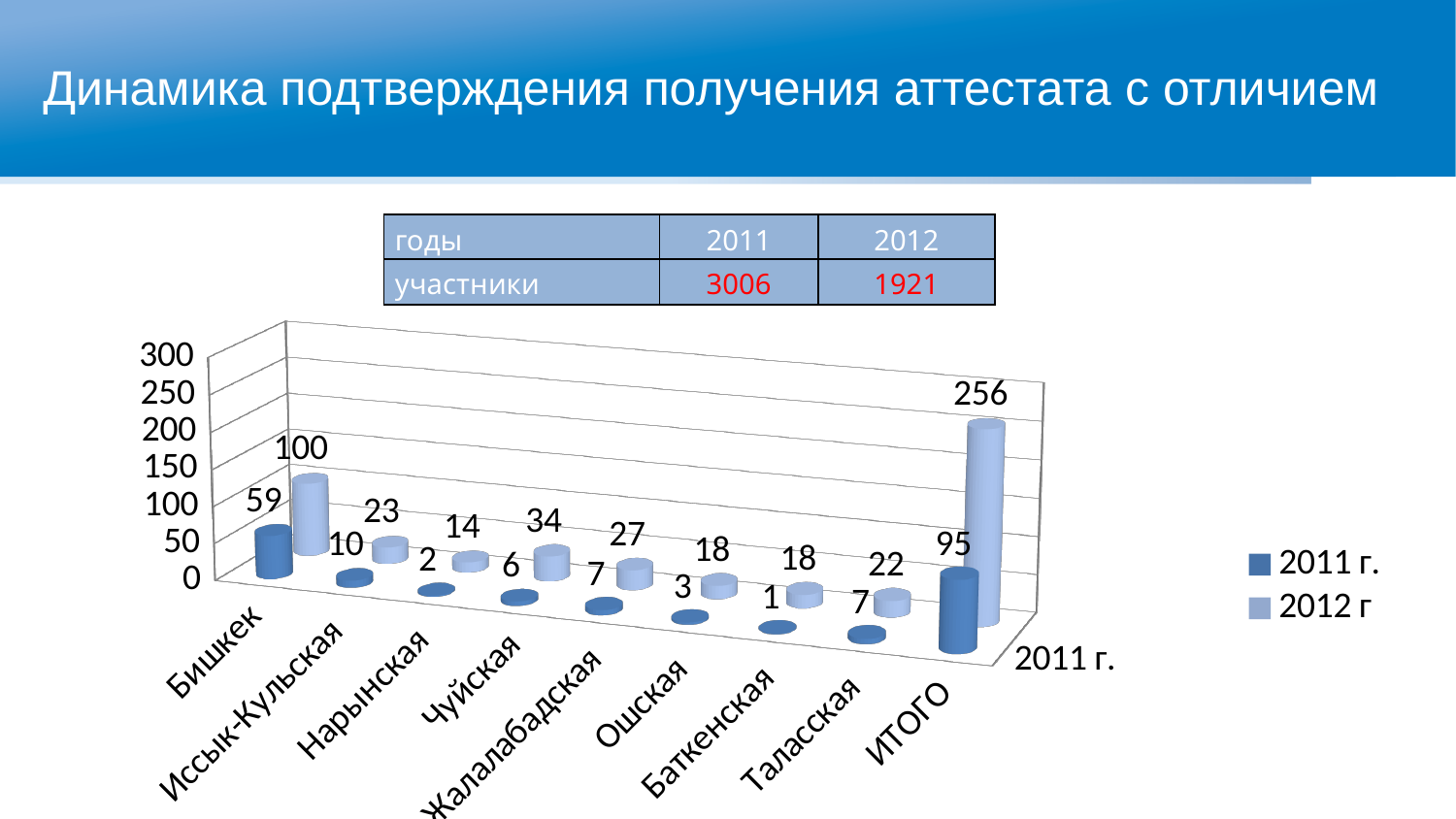
What is the value for Чуйская in the 2012 г series? 34 Which region (excluding ИТОГО) has the highest value in the 2012 г series? Бишкек What is the value for ИТОГО in the 2012 г series? 256 Which region (excluding ИТОГО) has the lowest value in the 2011 г. series? Баткенская What is the difference between the 2012 г and 2011 г. values for Бишкек? 41 How many series does the legend list? 2 What is the value for Бишкек in the 2012 г series? 100 What is the value for Таласская in the 2011 г. series? 7 Which is larger for Жалалабадская: the 2011 г. value or the 2012 г value? 2012 г How many categories are shown on the x axis? 9 What kind of chart is shown on the slide? bar chart What is the value for Бишкек in the 2011 г. series? 59